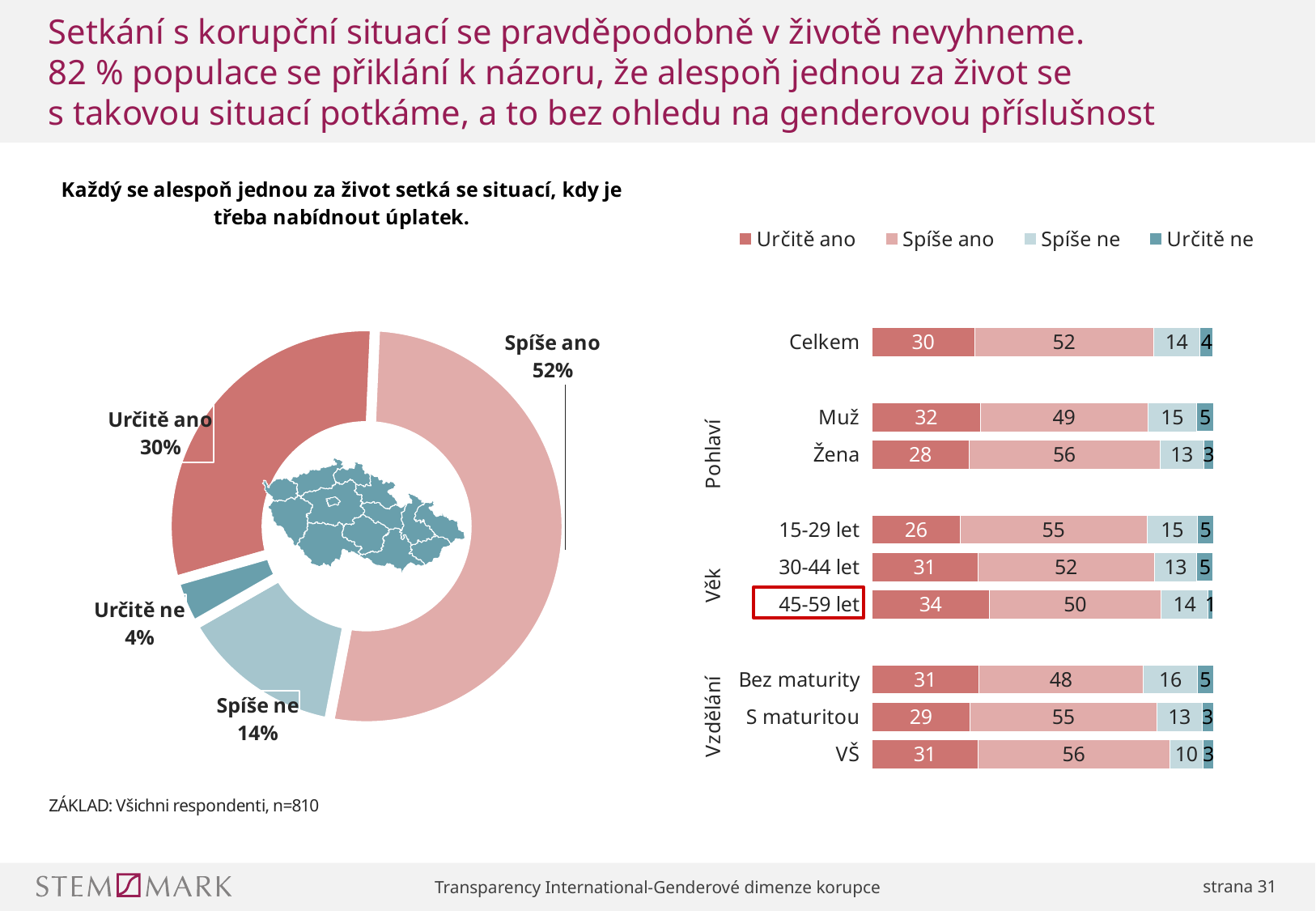
In the donut chart on the left, which answer has the largest share? Spíše ano In the stacked bar chart on the right, what is the "Určitě ne" value for "45-59 let"? 1 In the donut chart on the left, what share of respondents answered "Spíše ano"? 52% In the donut chart on the left, how many slices are there? 4 In the stacked bar chart on the right, what is the difference between the "Spíše ano" values for "Žena" and "Muž"? 7 In the stacked bar chart on the right, which is larger: the "Spíše ne" value for "Bez maturity" or for "VŠ"? Bez maturity In the donut chart on the left, which answer has the smallest share? Určitě ne In the stacked bar chart on the right, which category has the highest "Určitě ano" value? 45-59 let In the stacked bar chart on the right, what is the "Určitě ano" value for "Muž"? 32 What type of chart is shown on the right side of the slide? Stacked bar chart In the stacked bar chart on the right, what is the "Spíše ano" value for "VŠ"? 56 How many series does the legend of the stacked bar chart on the right list? 4